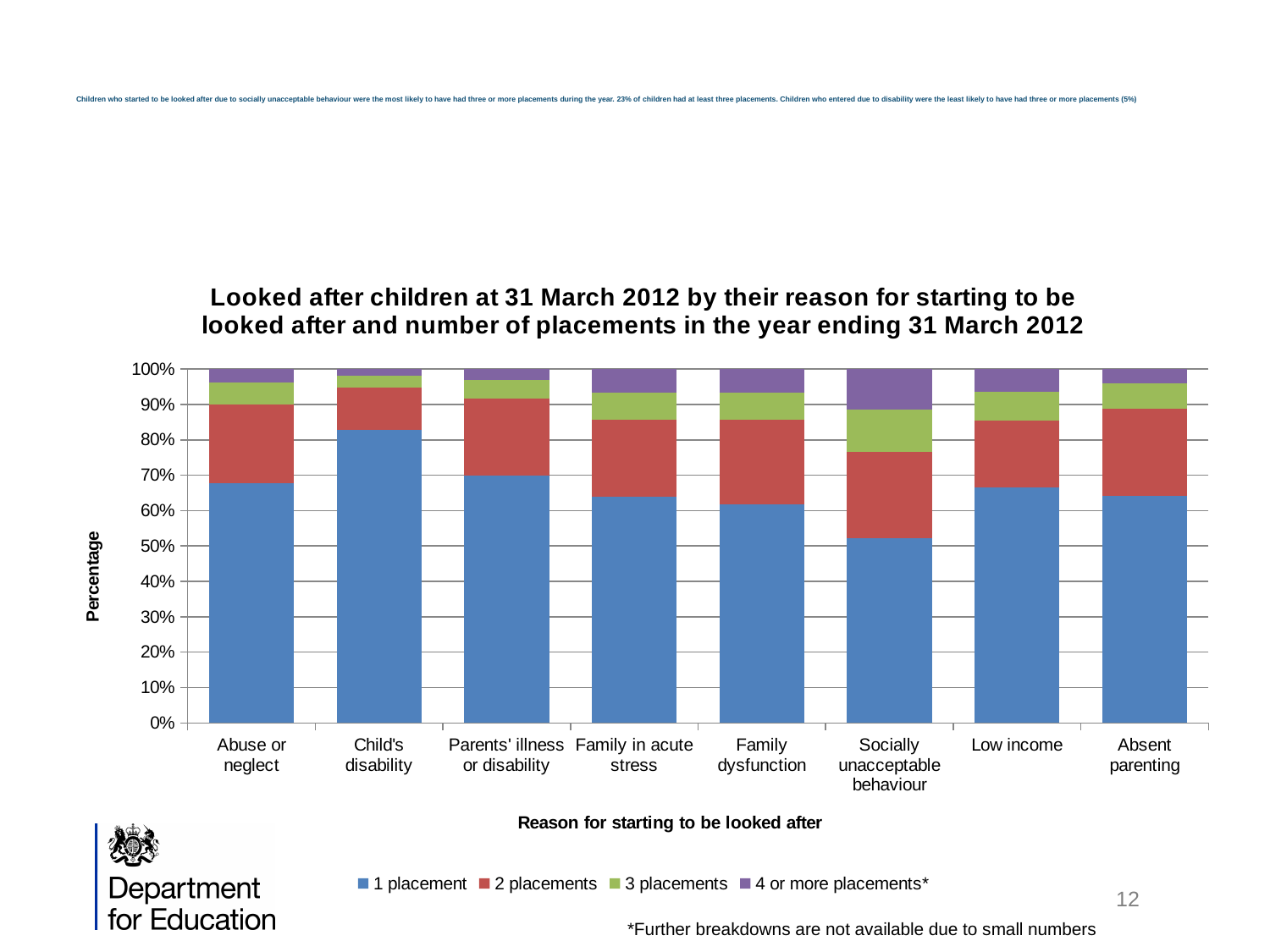
Is the share of children with 1 placement for Abuse or neglect greater or less than 60%? greater What is the label on the vertical axis of the chart? Percentage Which reason for starting to be looked after has the highest share of children with 1 placement? Child's disability Which reason for starting to be looked after has the lowest share of children with 1 placement? Socially unacceptable behaviour Is the share of children with 1 placement for Socially unacceptable behaviour greater or less than 60%? less What kind of chart is shown on the slide? Stacked bar chart How many reasons for starting to be looked after are shown on the x axis? 8 Is the share of children with 1 placement for Child's disability greater or less than 80%? greater How many series does the legend list? 4 Which has a larger share of children with 1 placement, Socially unacceptable behaviour or Parents' illness or disability? Parents' illness or disability Which legend entry is marked with an asterisk? 4 or more placements* Which has a larger share of children with 1 placement, Child's disability or Low income? Child's disability